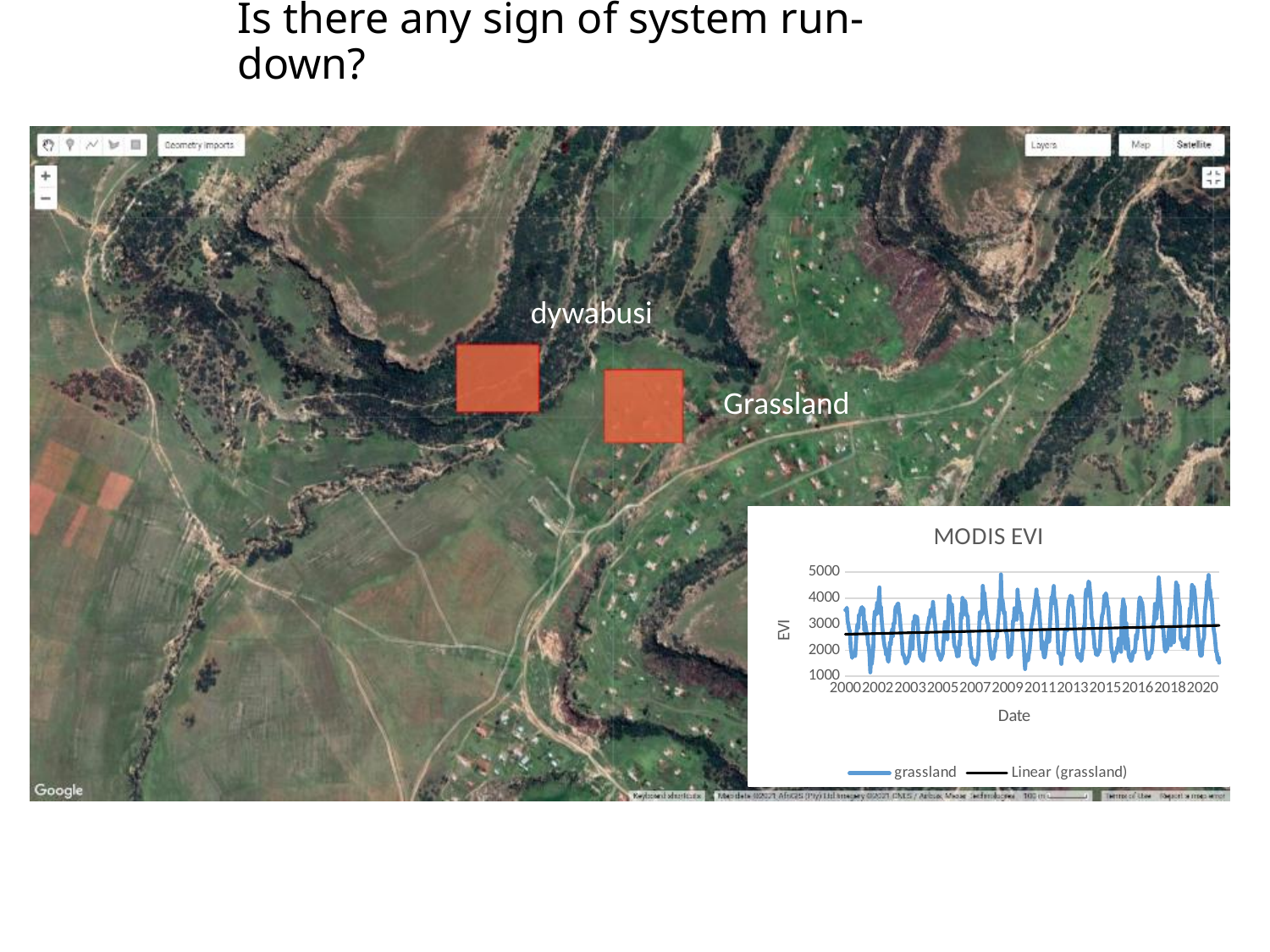
How many series does the legend of the MODIS EVI chart list? 2 In the MODIS EVI chart, are the lowest troughs of the grassland series greater or less than 2000? less In the MODIS EVI chart, is the linear trendline value in 2000 greater or less than 3000? less What is the highest tick value shown on the vertical axis of the MODIS EVI chart? 5000 What are the two legend entries of the MODIS EVI chart? grassland and Linear (grassland) What is the label of the vertical axis of the MODIS EVI chart? EVI In the MODIS EVI chart, is the highest peak of the grassland series greater or less than 4000? greater What is the title of the chart embedded in the map? MODIS EVI What kind of chart is the MODIS EVI chart on the slide? line chart What is the first year shown on the horizontal axis of the MODIS EVI chart? 2000 In the MODIS EVI chart, does the linear trendline for grassland rise or fall from 2000 to 2020? rise